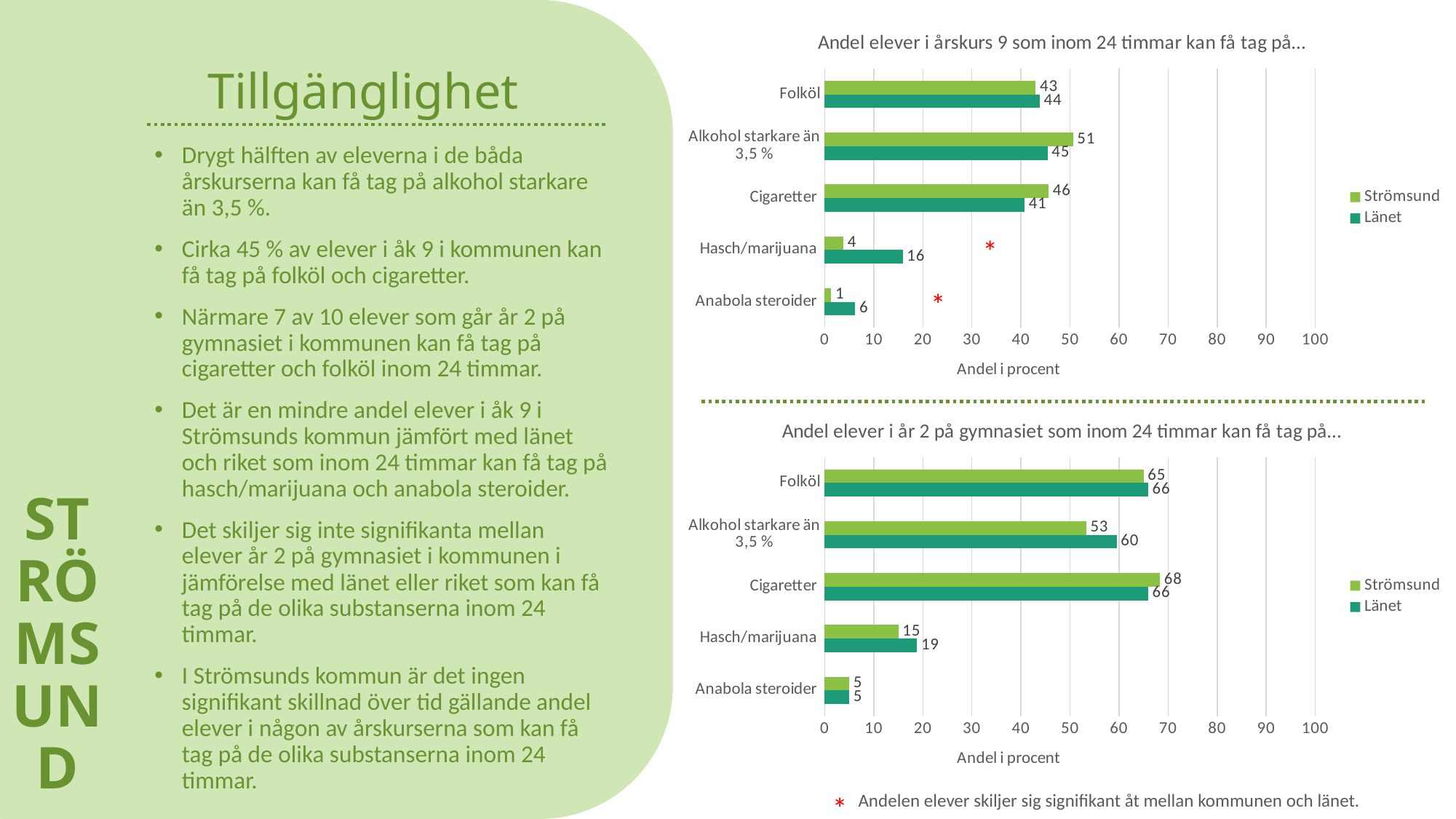
In the top chart (årskurs 9), what is the value for Länet for Hasch/marijuana? 16 In the top chart (årskurs 9), which is larger for Cigaretter, Strömsund or Länet? Strömsund In the top chart (årskurs 9), which category has the lowest value for Strömsund? Anabola steroider In the top chart (årskurs 9), what is the value for Strömsund for Alkohol starkare än 3,5 %? 51 In the bottom chart (år 2 på gymnasiet), what is the value for Länet for Alkohol starkare än 3,5 %? 60 How many series does the legend of the top chart (årskurs 9) list? 2 How many categories are shown in the bottom chart (år 2 på gymnasiet)? 5 In the bottom chart (år 2 på gymnasiet), which category has the highest value for Strömsund? Cigaretter What type of chart is the top chart (årskurs 9)? Bar chart In the bottom chart (år 2 på gymnasiet), what is the value for Strömsund for Anabola steroider? 5 In the top chart (årskurs 9), what is the difference between Länet and Strömsund for Hasch/marijuana? 12 In the bottom chart (år 2 på gymnasiet), what is the difference between Länet and Strömsund for Alkohol starkare än 3,5 %? 7